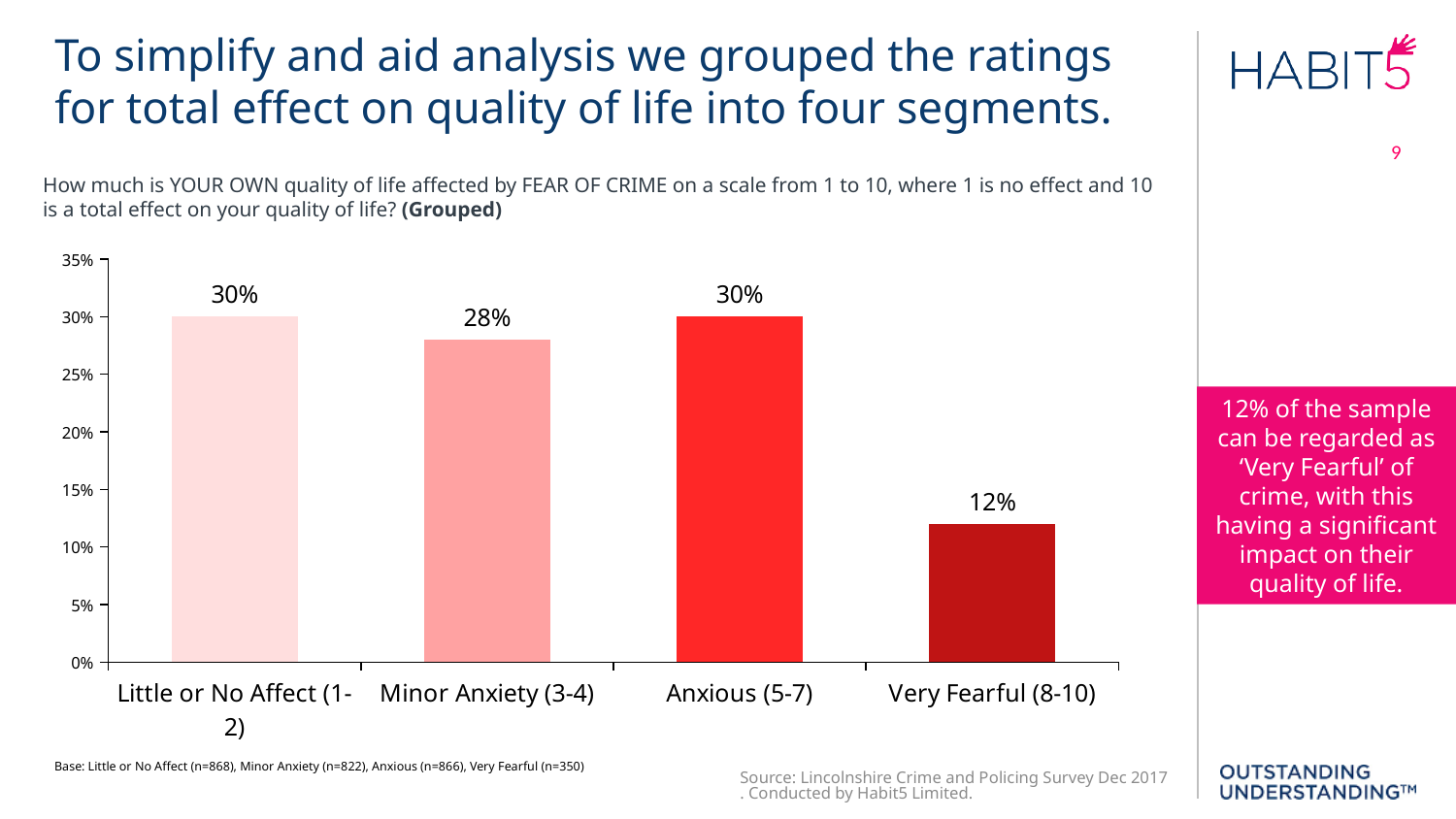
What is the difference between the values for Anxious (5-7) and Very Fearful (8-10)? 18% What is the value for Minor Anxiety (3-4)? 28% What is the value for Little or No Affect (1-2)? 30% What kind of chart is shown on the slide? bar chart How many categories are shown on the chart? 4 What is the value for Very Fearful (8-10)? 12% Is the value for Very Fearful (8-10) greater or less than 15%? less Which category has the lowest value? Very Fearful (8-10) What is the highest value shown on the vertical axis? 35% What is the difference between the values for Little or No Affect (1-2) and Minor Anxiety (3-4)? 2% What is the value for Anxious (5-7)? 30% Which is larger, the value for Minor Anxiety (3-4) or the value for Very Fearful (8-10)? Minor Anxiety (3-4)